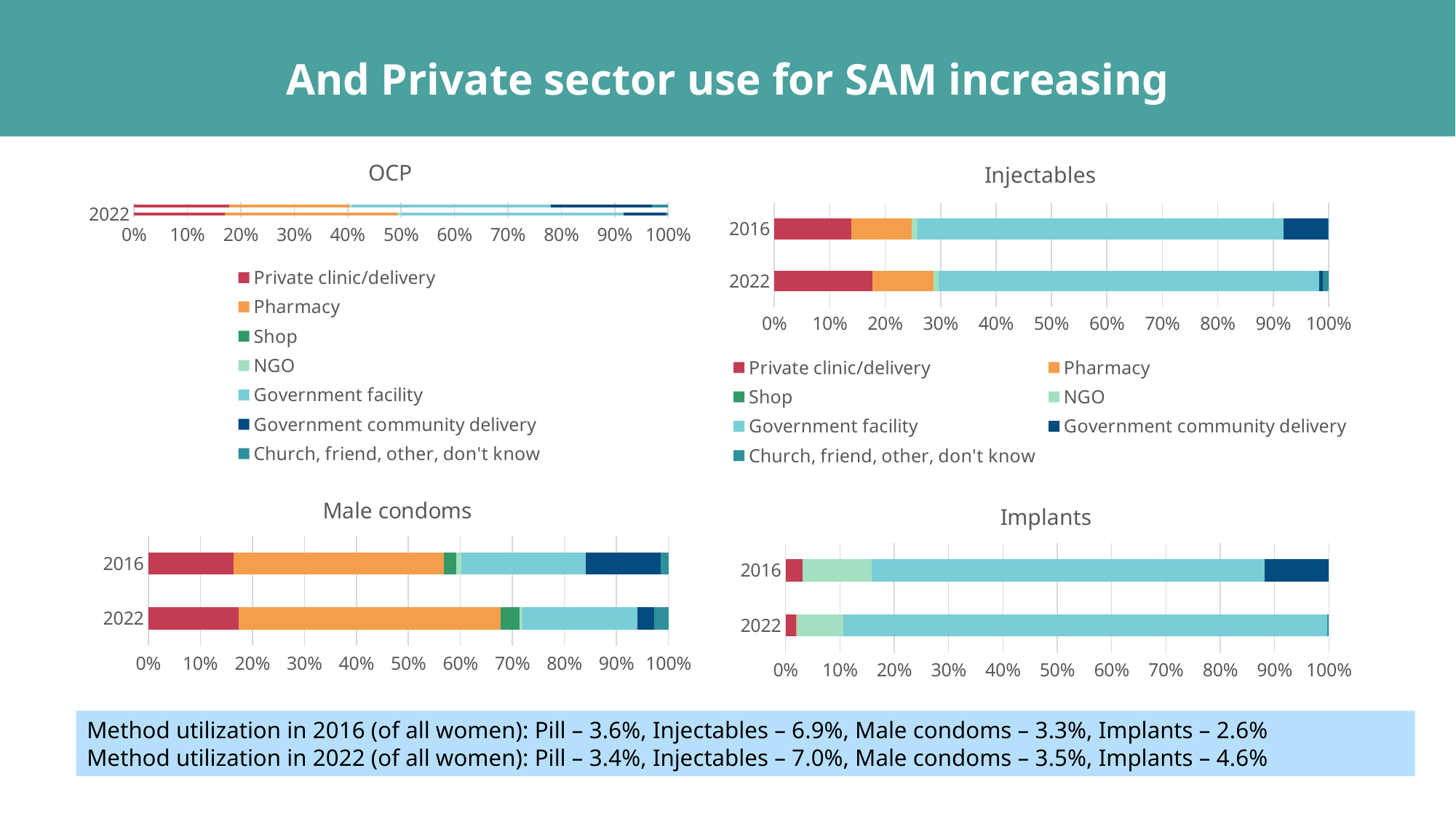
In the Implants chart, which year has the larger NGO share, 2016 or 2022? 2016 In the Male condoms chart, does the Government community delivery share rise or fall from 2016 to 2022? fall In the Male condoms chart for 2016, which segment is larger: Pharmacy or Private clinic/delivery? Pharmacy In the Injectables chart, does the Private clinic/delivery share rise or fall from 2016 to 2022? rise How many series does the legend of the Injectables chart list? 7 In the Injectables chart, is the Private clinic/delivery share for 2016 greater or less than 20%? less How many years (categories) are shown on the Male condoms chart? 2 What kind of chart is the Injectables chart? Stacked bar chart In the Implants chart, is the Government facility share for 2022 greater or less than 80%? greater What is the title of the chart in the bottom-right of the slide? Implants In the Male condoms chart, is the Pharmacy share for 2016 greater or less than 30%? greater In the Injectables chart, which year has the larger Government community delivery share, 2016 or 2022? 2016